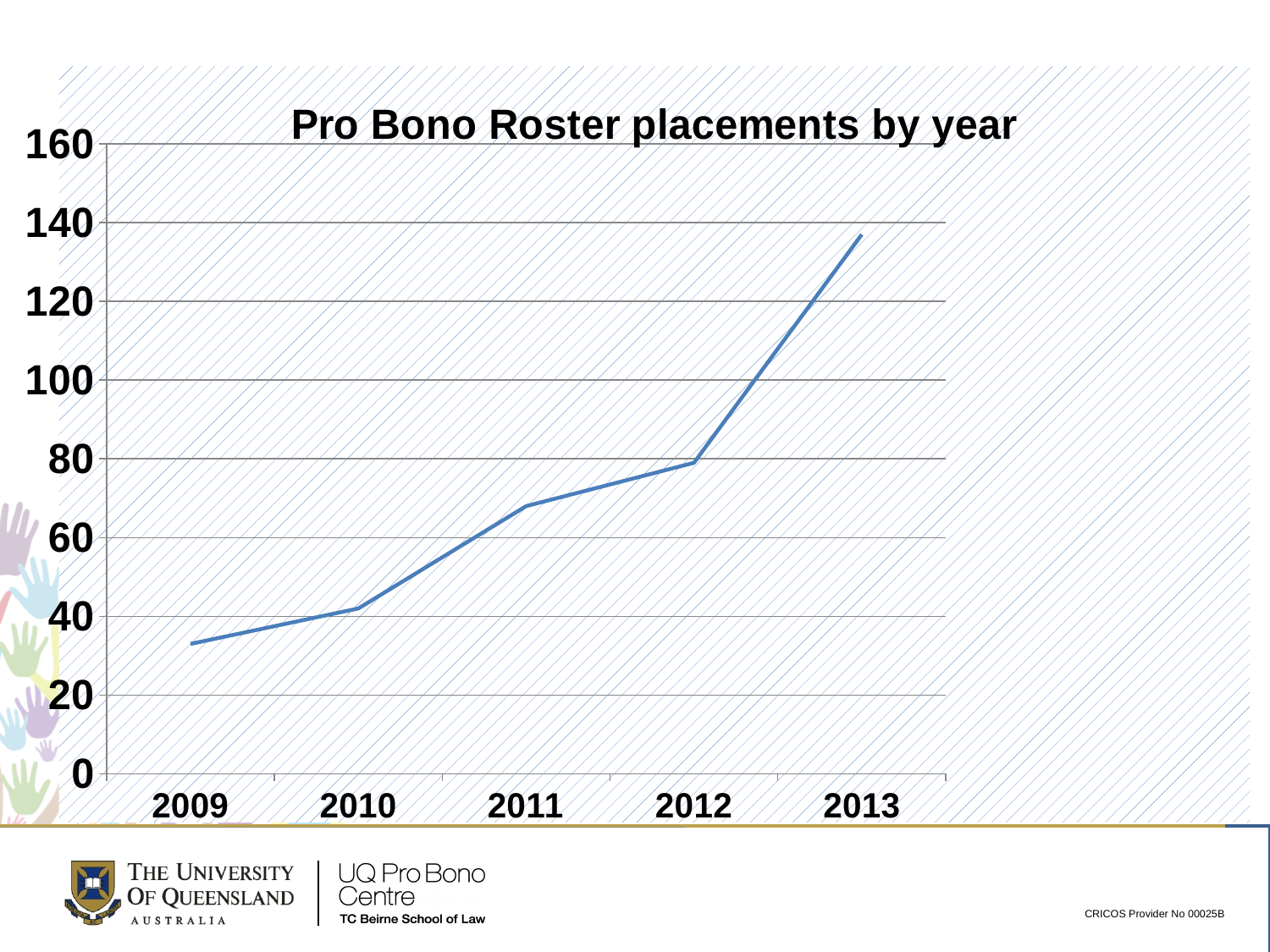
What is the title of the chart? Pro Bono Roster placements by year Which year has more placements, 2010 or 2012? 2012 Is the value for 2013 greater or less than 120? greater Which year has the highest number of Pro Bono Roster placements? 2013 What is the highest value shown on the y axis of the chart? 160 Is the value for 2009 greater or less than 40? less Do the Pro Bono Roster placements rise or fall from 2009 to 2013? rise Is the value for 2012 greater or less than 100? less What kind of chart is shown on the slide? line chart Which year has the lowest number of Pro Bono Roster placements? 2009 How many years are plotted on the x axis of the chart? 5